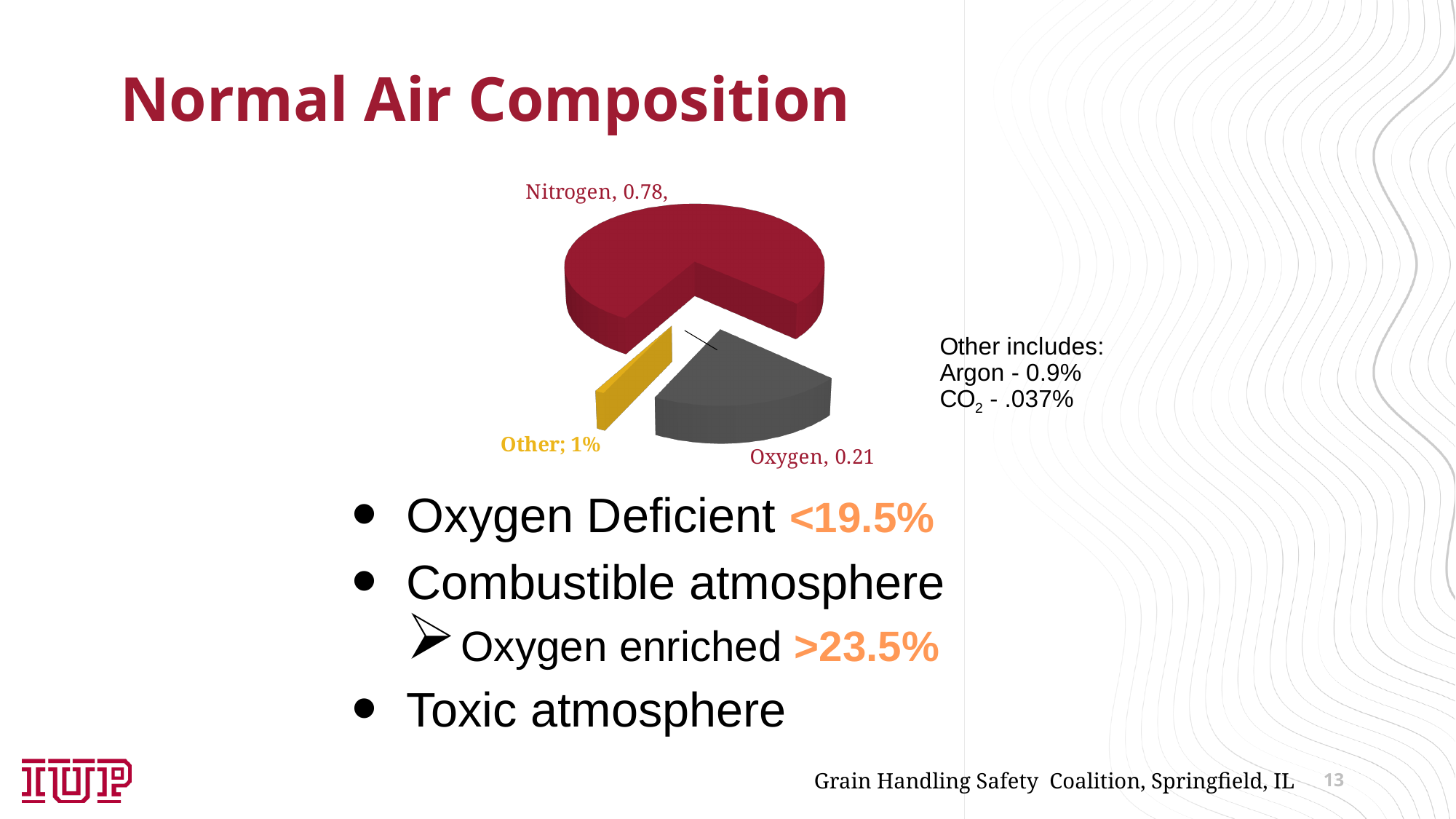
Which slice of the pie chart is the largest? Nitrogen What colour is the Nitrogen slice in the pie chart? Dark red Which slice of the pie chart is the smallest? Other What value is shown for the Other slice in the pie chart? 1% What kind of chart is shown on the slide? Pie chart What value is shown for Oxygen in the pie chart? 0.21 What value is shown for Nitrogen in the pie chart? 0.78 How many slices does the pie chart have? 3 What share of the pie does the Nitrogen slice represent, as labelled? 0.78 What colour is the Other slice in the pie chart? Gold What is the difference between the Nitrogen value and the Oxygen value in the pie chart? 0.57 Which is larger in the pie chart, Oxygen or Other? Oxygen